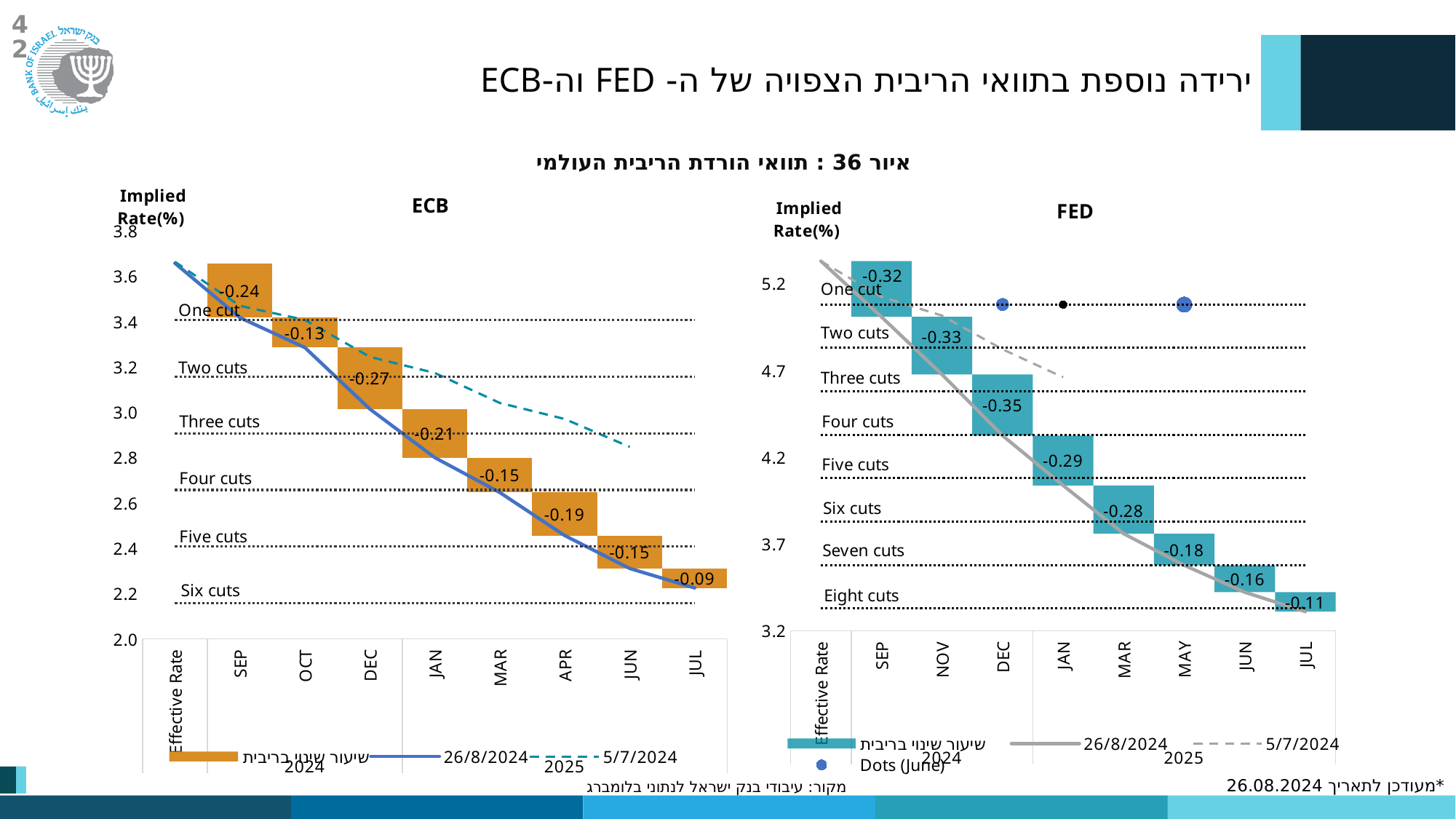
In the ECB chart, which month has the largest rate cut (most negative bar label)? DEC How many entries does the legend of the FED chart list? 4 How many monthly bars are plotted in the FED chart? 8 In the ECB chart, what is the data label on the bar for DEC? -0.27 In the ECB chart, does the 26/8/2024 implied rate line rise or fall from left to right? fall In the FED chart, what is the data label on the bar for DEC? -0.35 In the ECB chart, what is the data label on the bar for SEP? -0.24 What is the title of the right-hand chart? FED In the FED chart, which bar shows a larger cut in magnitude: NOV or JUN? NOV In the ECB chart, what is the difference between the bar labels for SEP (-0.24) and OCT (-0.13)? 0.11 In the FED chart, what is the data label on the bar for MAY? -0.18 In the FED chart, which month has the smallest rate cut (bar label closest to zero)? JUL